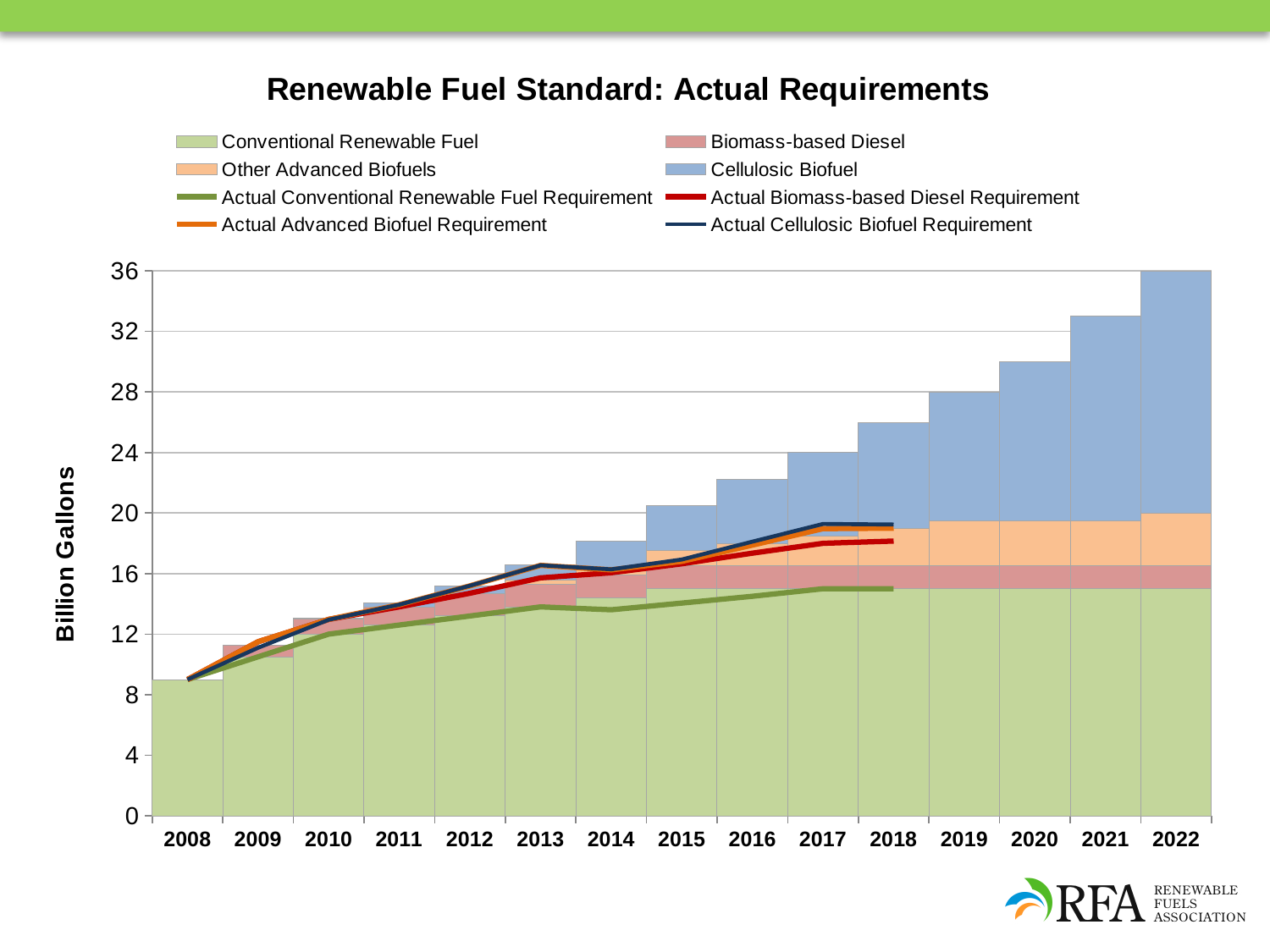
What is the total stacked value for 2022 in billion gallons? 36 Which year has the highest total stacked value? 2022 How many series does the legend list? 8 How many years are shown along the x axis? 15 In 2017, which is larger: the Actual Cellulosic Biofuel Requirement or the Actual Conventional Renewable Fuel Requirement? Actual Cellulosic Biofuel Requirement Which year has the lowest total stacked value? 2008 Is the Actual Conventional Renewable Fuel Requirement in 2018 greater or less than 16? less What is the title of the chart? Renewable Fuel Standard: Actual Requirements What kind of chart is shown on the slide? Stacked bar chart combined with line series What is the label on the y axis? Billion Gallons Does the total stacked value rise or fall from 2008 to 2022? rise Is the total stacked value for 2008 greater or less than 12? less